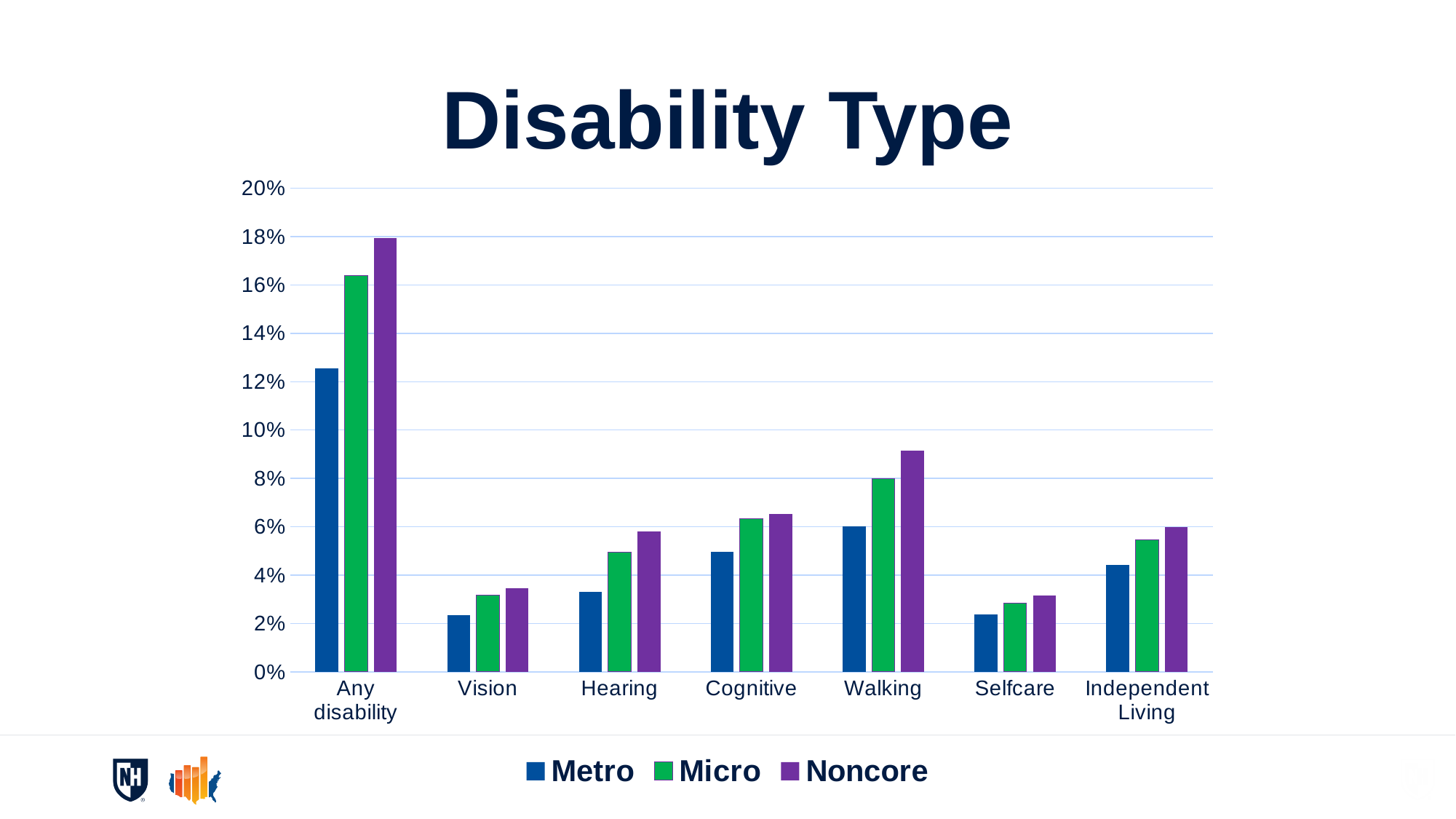
Is the Noncore value for Any disability greater or less than 16%? greater Is the Metro value for Hearing greater or less than 4%? less How many series does the legend list? 3 Which category has the highest Noncore value? Any disability Which is larger for Noncore: Walking or Cognitive? Walking Is the Metro value for Any disability greater or less than 14%? less What is the title of the chart? Disability Type Which series is shown in purple? Noncore What kind of chart is shown on the slide? bar chart Which is larger for Metro: Hearing or Cognitive? Cognitive How many disability categories are shown on the x axis? 7